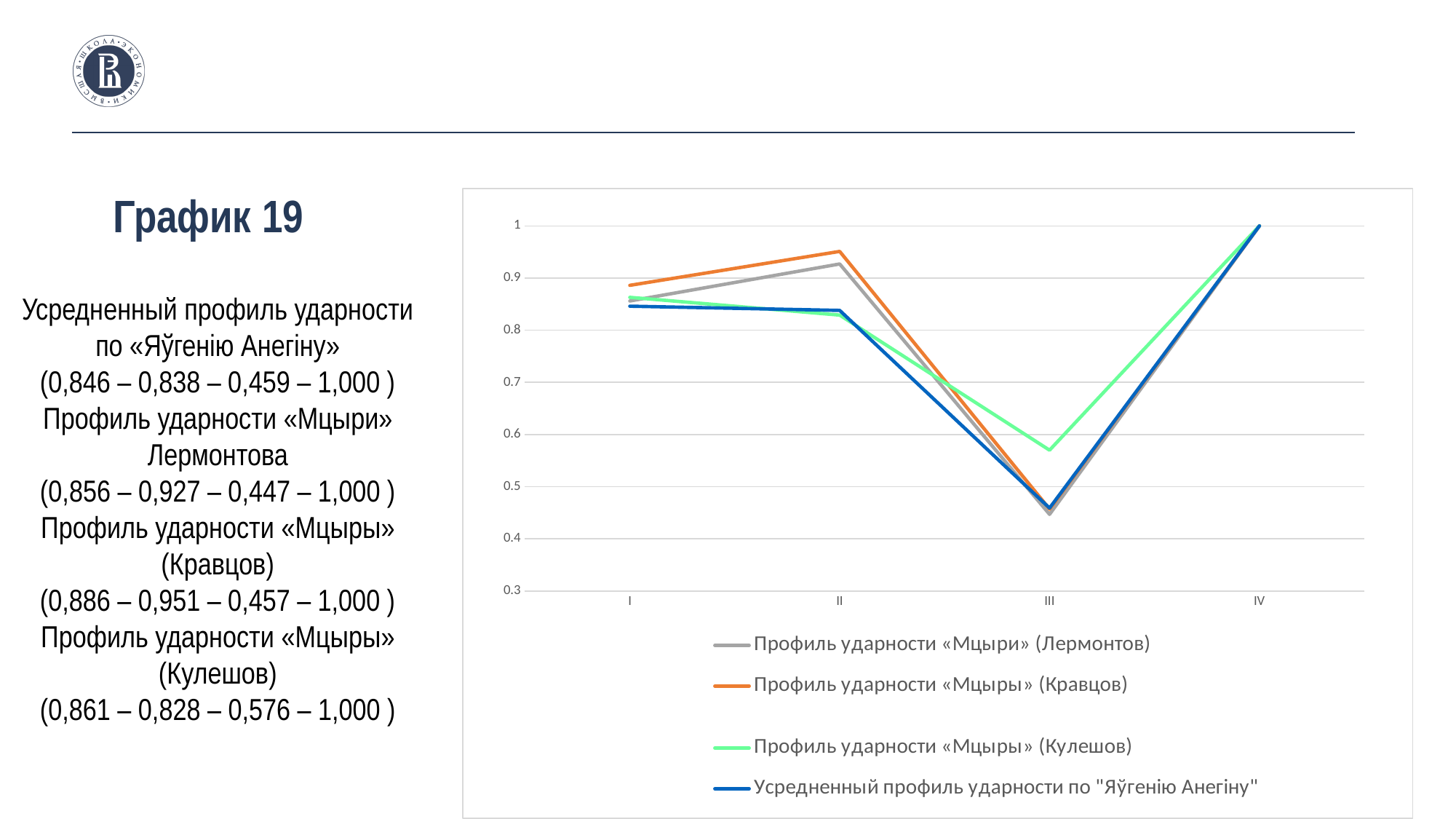
Do the values of the series rise or fall from point II to point III? fall What colour is the line for «Усредненный профиль ударности по "Яўгенію Анегіну"»? blue How many series does the chart legend list? 4 Is the value for «Профиль ударности «Мцыри» (Лермонтов)» at point III greater or less than 0.5? less Is the value for «Профиль ударности «Мцыры» (Кулешов)» at point III greater or less than 0.5? greater Is the value for «Профиль ударности «Мцыры» (Кравцов)» at point II greater or less than 0.9? greater Which series has the highest value at point II? Профиль ударности «Мцыры» (Кравцов) What kind of chart is shown on the slide? line chart At point II, which is larger: «Профиль ударности «Мцыры» (Кравцов)» or «Усредненный профиль ударности по "Яўгенію Анегіну"»? Профиль ударности «Мцыры» (Кравцов) What value do all the series reach at point IV? 1 How many points are there along the x axis of the chart? 4 Which series has the highest value at point III? Профиль ударности «Мцыры» (Кулешов)